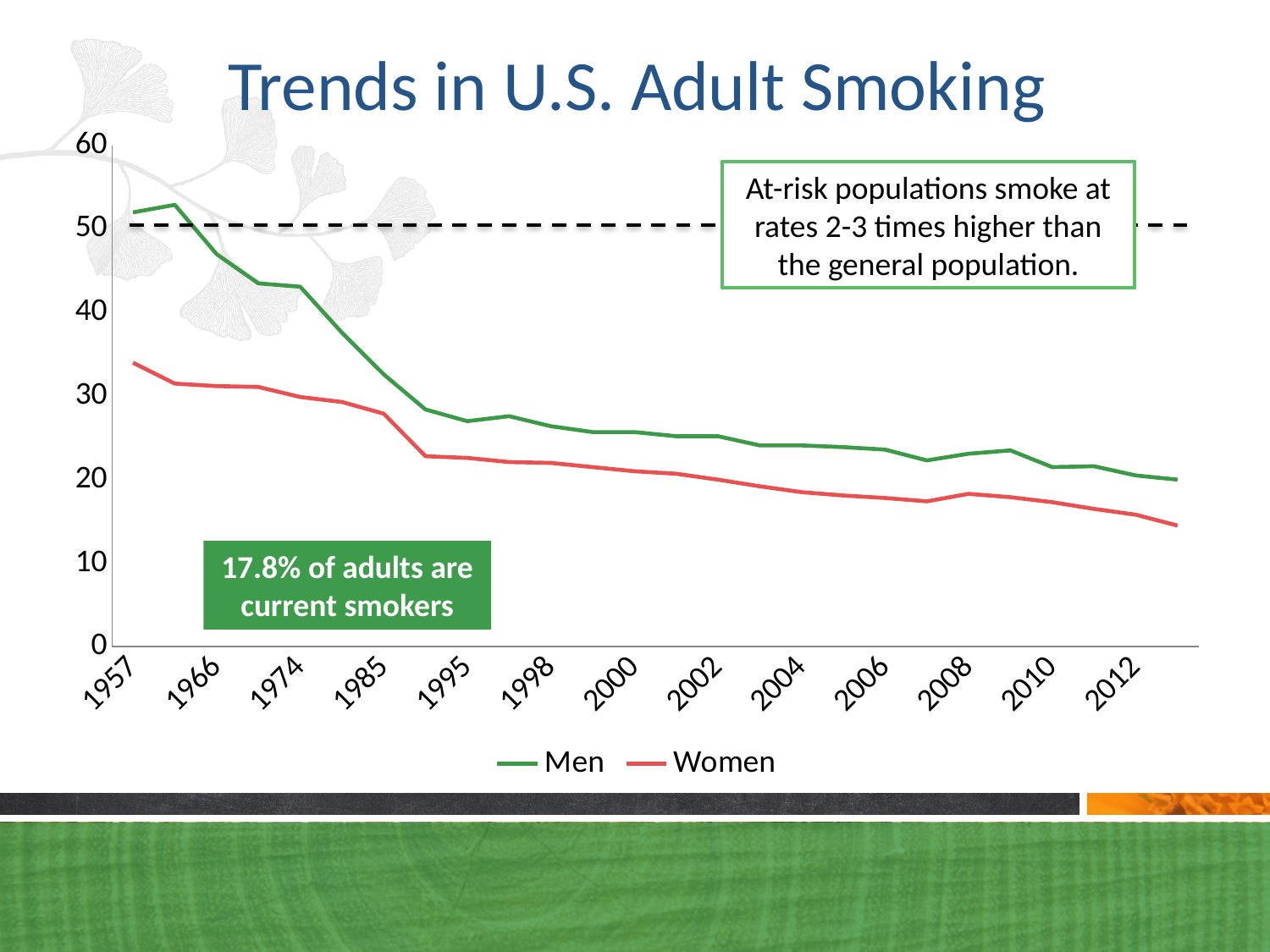
How many series does the legend list? 2 What kind of chart is shown on the slide? Line chart Do the values for Men rise or fall from 1957 to 2012? Fall Do the values for Women rise or fall across the years shown? Fall Is the value for Women in 2012 greater or less than 20? less Is the value for Men in 1966 greater or less than 50? less Is the value for Men in 2000 greater or less than 20? greater What is the title of the chart? Trends in U.S. Adult Smoking Which series is drawn in red? Women In 2000, which series has the higher value, Men or Women? Men